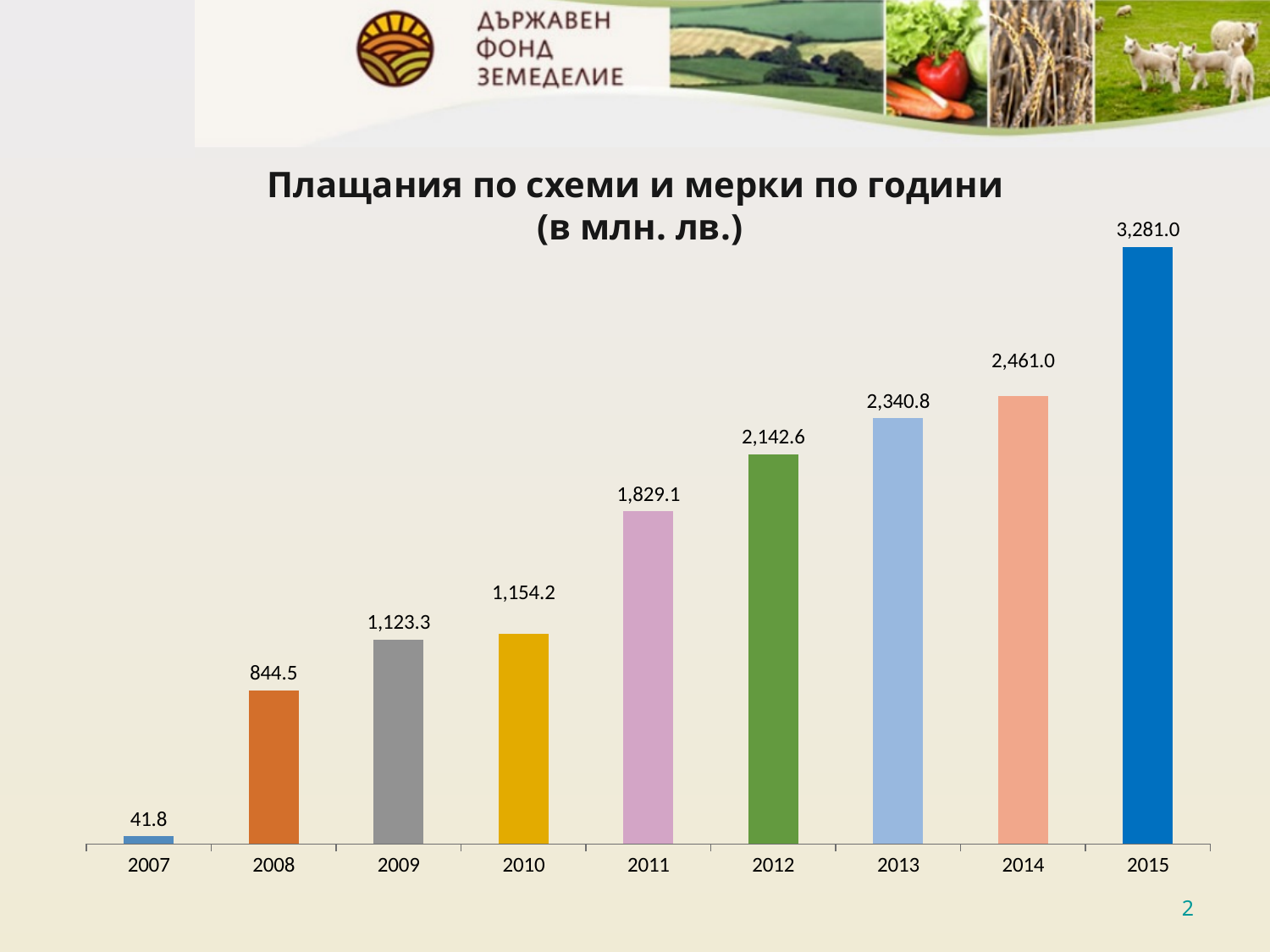
Which year has the lowest value? 2007 What is the value for 2013? 2,340.8 Do the values rise or fall from 2007 to 2015? Rise What is the difference between the values for 2010 and 2009? 30.9 What is the value for 2007? 41.8 What is the value for 2015? 3,281.0 Which is larger, the value for 2012 or the value for 2011? 2012 How many years are shown on the x axis? 9 Which year has the highest value? 2015 What kind of chart is shown on the slide? Bar chart What is the value for 2011? 1,829.1 What is the difference between the values for 2015 and 2014? 820.0